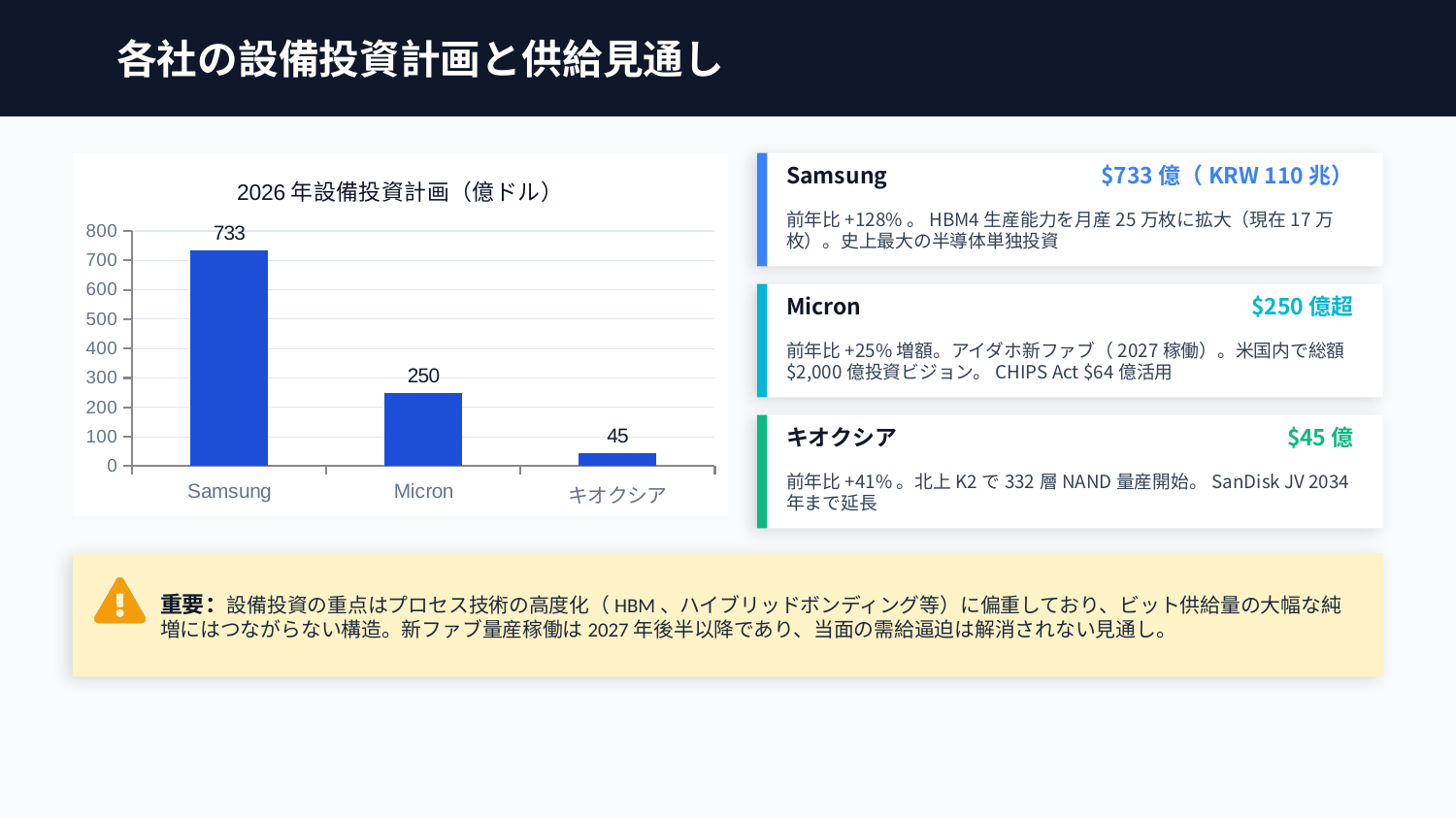
What is the value for キオクシア in the chart? 45 Which company has the lowest capital investment plan in the chart? キオクシア What is the difference between Samsung's and Micron's values in the chart? 483 What is the value for Micron in the chart? 250 Which company has the highest capital investment plan in the chart? Samsung Is the value for Samsung greater or less than 700? greater What is the difference between Micron's and キオクシア's values in the chart? 205 Which is larger in the chart, the value for Micron or the value for キオクシア? Micron How many companies are shown in the chart? 3 What is the title of the chart? 2026年設備投資計画（億ドル） What kind of chart is shown on the slide? bar chart What is the value for Samsung in the 2026年設備投資計画 chart? 733